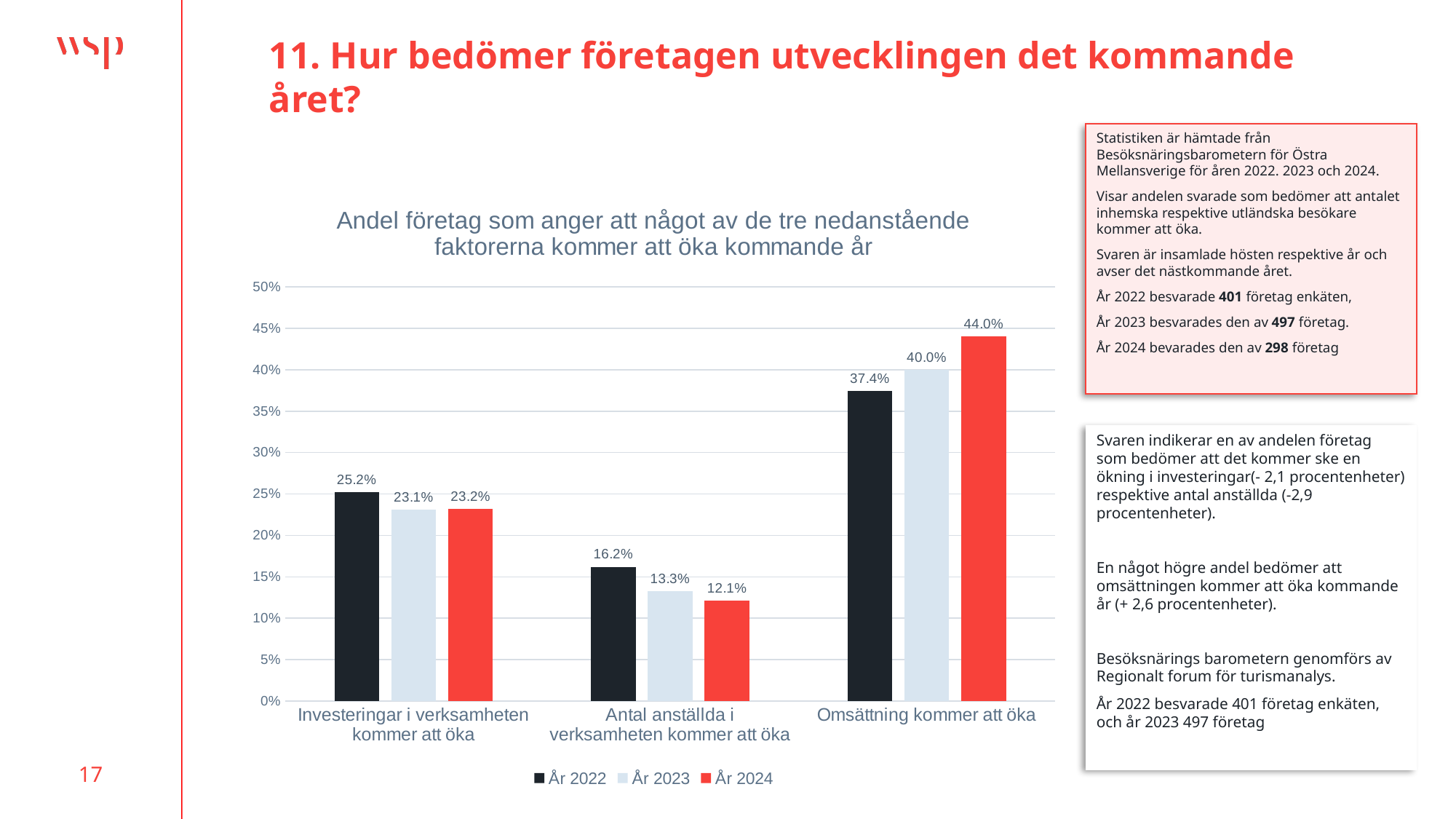
Do the values for "Omsättning kommer att öka" rise or fall from År 2022 to År 2024? Rise What kind of chart is shown on the slide? Bar chart Which category has the lowest value for År 2024? Antal anställda i verksamheten kommer att öka What is the value for År 2023 in the category "Antal anställda i verksamheten kommer att öka"? 13.3% What is the difference between the År 2024 and År 2022 values for "Omsättning kommer att öka"? 6.6 percentage points What is the value for År 2024 in the category "Omsättning kommer att öka"? 44.0% Which category has the highest value for År 2022? Omsättning kommer att öka How many categories are shown on the x axis? 3 For "Antal anställda i verksamheten kommer att öka", which is larger: the År 2022 value or the År 2024 value? År 2022 What is the value for År 2022 in the category "Investeringar i verksamheten kommer att öka"? 25.2% How many series does the legend list? 3 Is the År 2023 value for "Omsättning kommer att öka" greater or less than 35%? greater